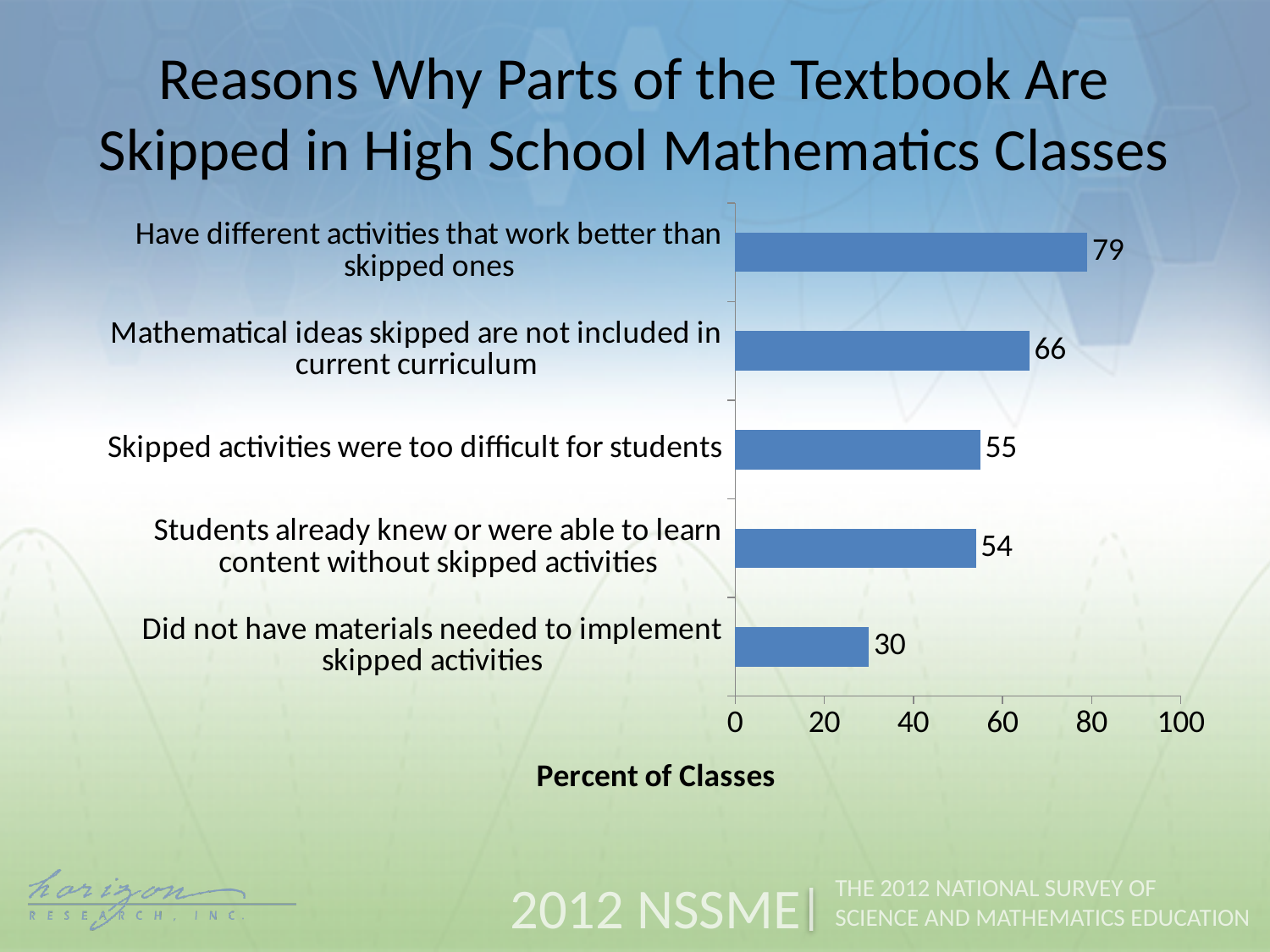
Is the value for 'Skipped activities were too difficult for students' greater or less than 40? greater Which reason has the lowest percent of classes? Did not have materials needed to implement skipped activities Which is larger: the value for 'Mathematical ideas skipped are not included in current curriculum' or the value for 'Students already knew or were able to learn content without skipped activities'? Mathematical ideas skipped are not included in current curriculum What kind of chart is shown on the slide? Bar chart What is the difference between the values for 'Mathematical ideas skipped are not included in current curriculum' and 'Skipped activities were too difficult for students'? 11 What percent of classes skipped parts of the textbook because they have different activities that work better than skipped ones? 79 How many reasons are shown in the chart? 5 Which reason has the highest percent of classes? Have different activities that work better than skipped ones What is the value for 'Mathematical ideas skipped are not included in current curriculum'? 66 What is the label of the horizontal axis? Percent of Classes What is the difference between the values for 'Have different activities that work better than skipped ones' and 'Did not have materials needed to implement skipped activities'? 49 What is the value for 'Did not have materials needed to implement skipped activities'? 30